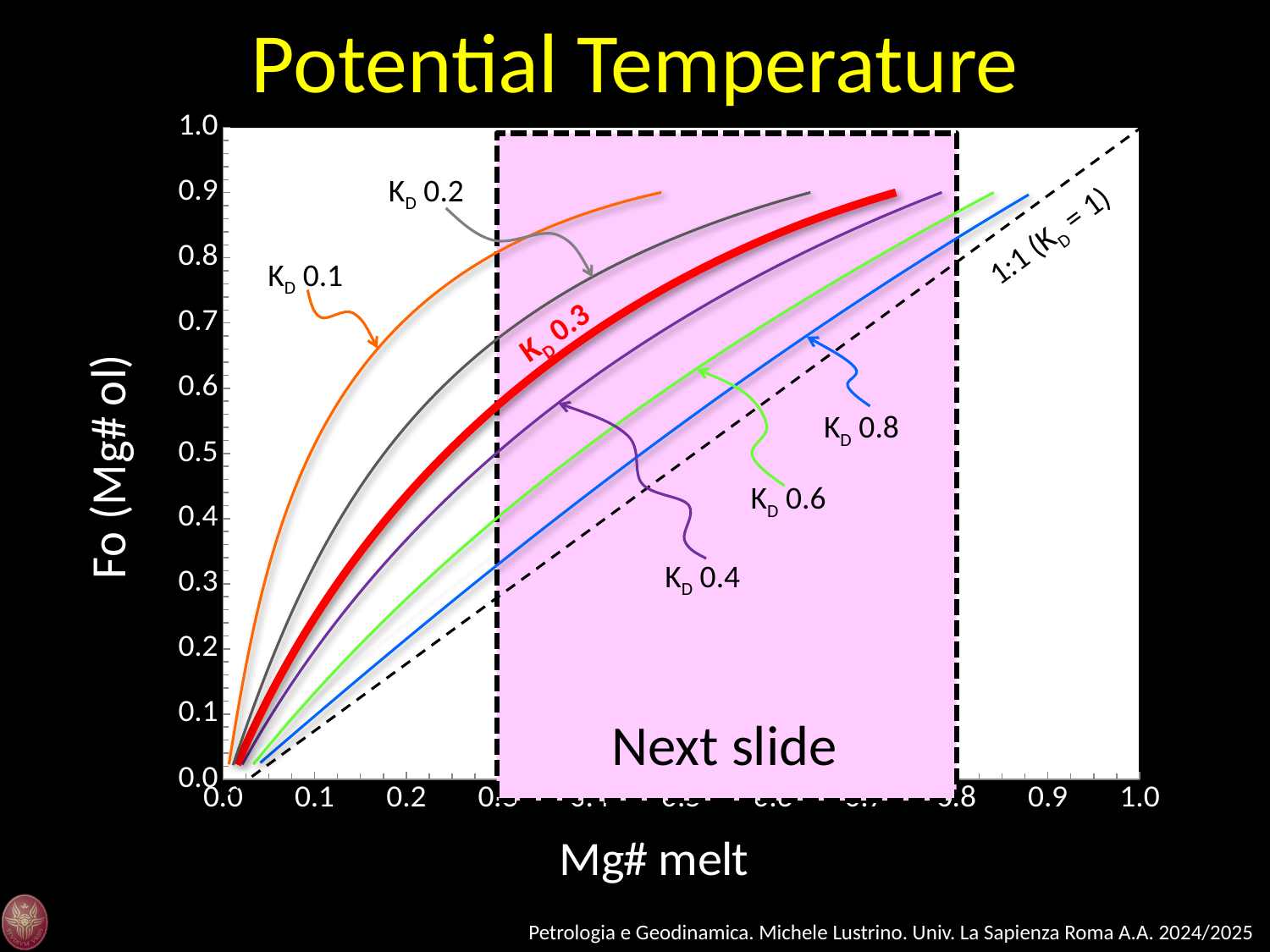
Which labelled curve has the highest Fo value at Mg# melt = 0.2? KD 0.1 How many KD curves (excluding the 1:1 line) are labelled on the chart? 6 What is the label of the y axis of the chart? Fo (Mg# ol) At Mg# melt = 0.3, is the Fo value of the KD 0.8 curve greater or less than 0.4? less What is the title of the chart? Potential Temperature At Mg# melt = 0.3, is the Fo value of the KD 0.3 curve greater or less than 0.5? greater What kind of chart is shown on the slide? line chart Which labelled KD curve lies lowest, closest to the 1:1 line? KD 0.8 At Mg# melt = 0.5, is the Fo value of the KD 0.3 curve greater or less than 0.7? greater Do the curves rise or fall as Mg# melt increases along the x axis? rise At Mg# melt = 0.4, which curve has the higher Fo value, KD 0.2 or KD 0.6? KD 0.2 What is the highest value shown on the x axis of the chart? 1.0